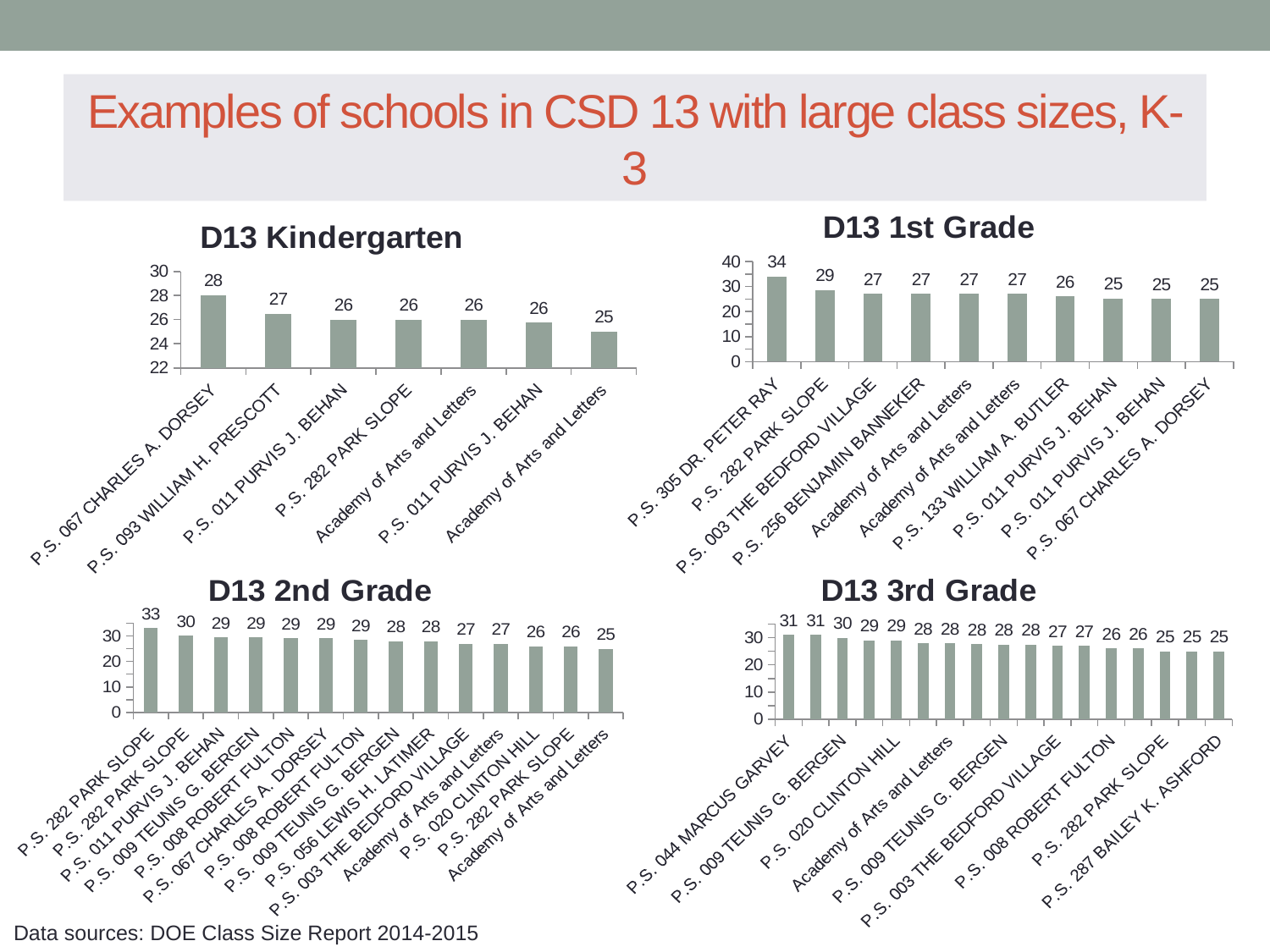
In the D13 1st Grade chart, what is the value for P.S. 133 WILLIAM A. BUTLER? 26 What type of chart is the D13 Kindergarten chart? Bar chart In the D13 2nd Grade chart, what is the highest value shown? 33 In the D13 1st Grade chart, how many bars are plotted? 10 In the D13 2nd Grade chart, what is the value for P.S. 056 LEWIS H. LATIMER? 28 In the D13 Kindergarten chart, what is the value for P.S. 067 CHARLES A. DORSEY? 28 In the D13 3rd Grade chart, how many bars are plotted? 17 In the D13 3rd Grade chart, what is the lowest value shown? 25 In the D13 Kindergarten chart, what is the value for P.S. 093 WILLIAM H. PRESCOTT? 27 In the D13 1st Grade chart, what is the difference between P.S. 305 DR. PETER RAY and P.S. 282 PARK SLOPE? 5 In the D13 2nd Grade chart, which is larger, the value for P.S. 011 PURVIS J. BEHAN or the value for P.S. 020 CLINTON HILL? P.S. 011 PURVIS J. BEHAN In the D13 1st Grade chart, which school has the highest value? P.S. 305 DR. PETER RAY